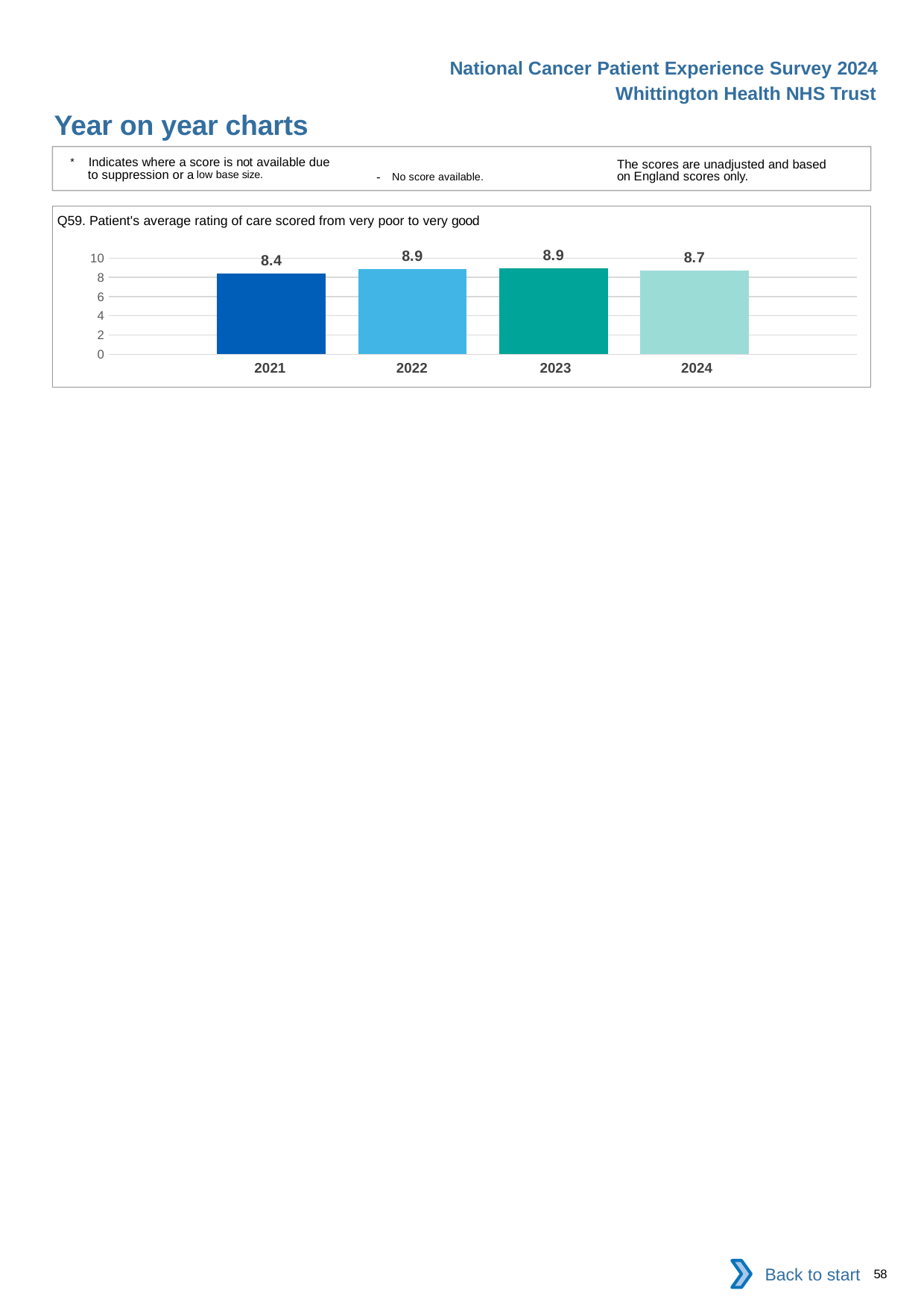
Which is larger, the value for 2021 or the value for 2024? 2024 What is the title of the chart? Q59. Patient's average rating of care scored from very poor to very good Does the value rise or fall from 2023 to 2024? fall What kind of chart is shown? bar chart What is the value for 2024? 8.7 What is the value for 2021? 8.4 What is the value for 2022? 8.9 What is the difference between the values for 2022 and 2021? 0.5 Which year has the lowest value? 2021 Is the value for 2021 greater or less than 8? greater What is the difference between the values for 2023 and 2024? 0.2 How many years are shown on the chart? 4